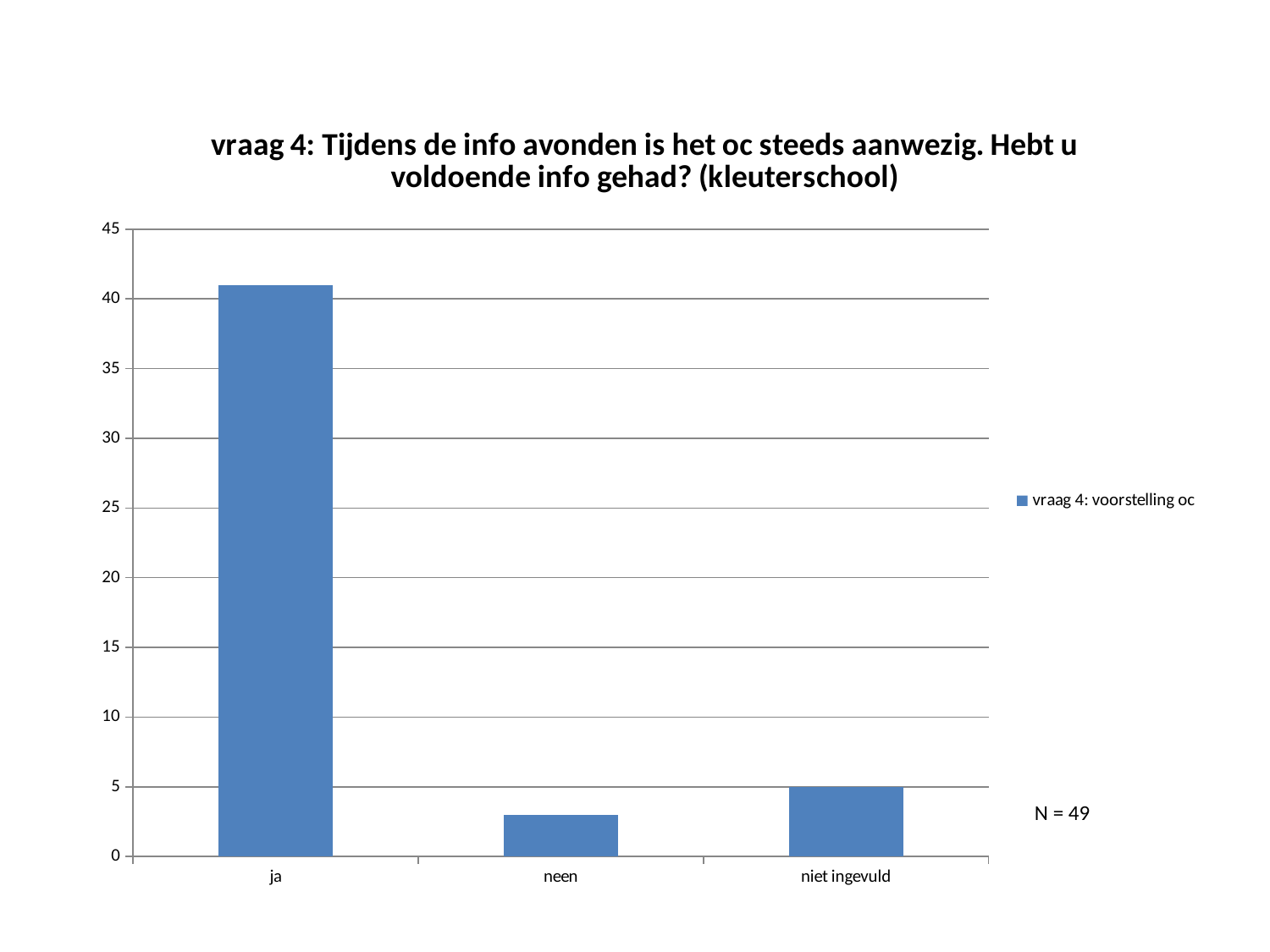
Which is larger, the value for 'ja' or the value for 'niet ingevuld'? ja Is the value for 'ja' greater or less than 40? greater Which category has the lowest value? neen Which is larger, the value for 'neen' or the value for 'niet ingevuld'? niet ingevuld What sample size (N) is stated on the slide? N = 49 Which category has the highest value? ja What kind of chart is shown on the slide? bar chart What is the name of the series shown in the legend? vraag 4: voorstelling oc Is the value for 'neen' greater or less than 5? less What is the value for 'niet ingevuld'? 5 How many categories are shown on the x axis? 3 How many series does the legend list? 1